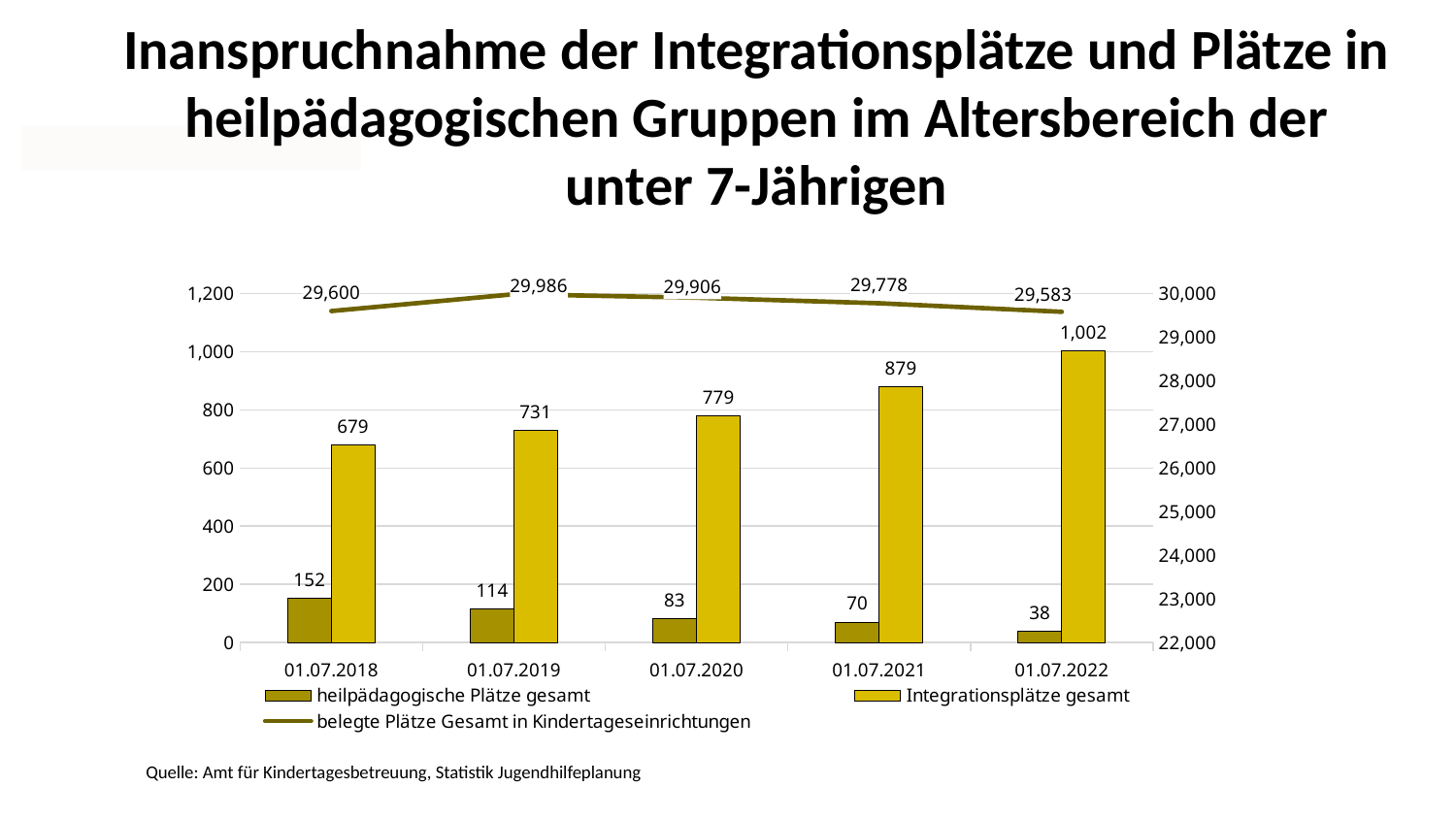
What is the value for heilpädagogische Plätze gesamt on 01.07.2018? 152 Do the values for heilpädagogische Plätze gesamt rise or fall from 01.07.2018 to 01.07.2022? fall What is the value for belegte Plätze Gesamt in Kindertageseinrichtungen on 01.07.2019? 29,986 On which date is the value for heilpädagogische Plätze gesamt lowest? 01.07.2022 How many series does the legend list? 3 What is the source given below the chart? Amt für Kindertagesbetreuung, Statistik Jugendhilfeplanung What is the difference between Integrationsplätze gesamt on 01.07.2021 and on 01.07.2020? 100 How many dates are shown on the x axis? 5 What kind of chart is shown on the slide? Combined bar and line chart What is the value for Integrationsplätze gesamt on 01.07.2022? 1,002 On which date is the value for Integrationsplätze gesamt highest? 01.07.2022 Which is larger: heilpädagogische Plätze gesamt on 01.07.2019 or on 01.07.2020? 01.07.2019